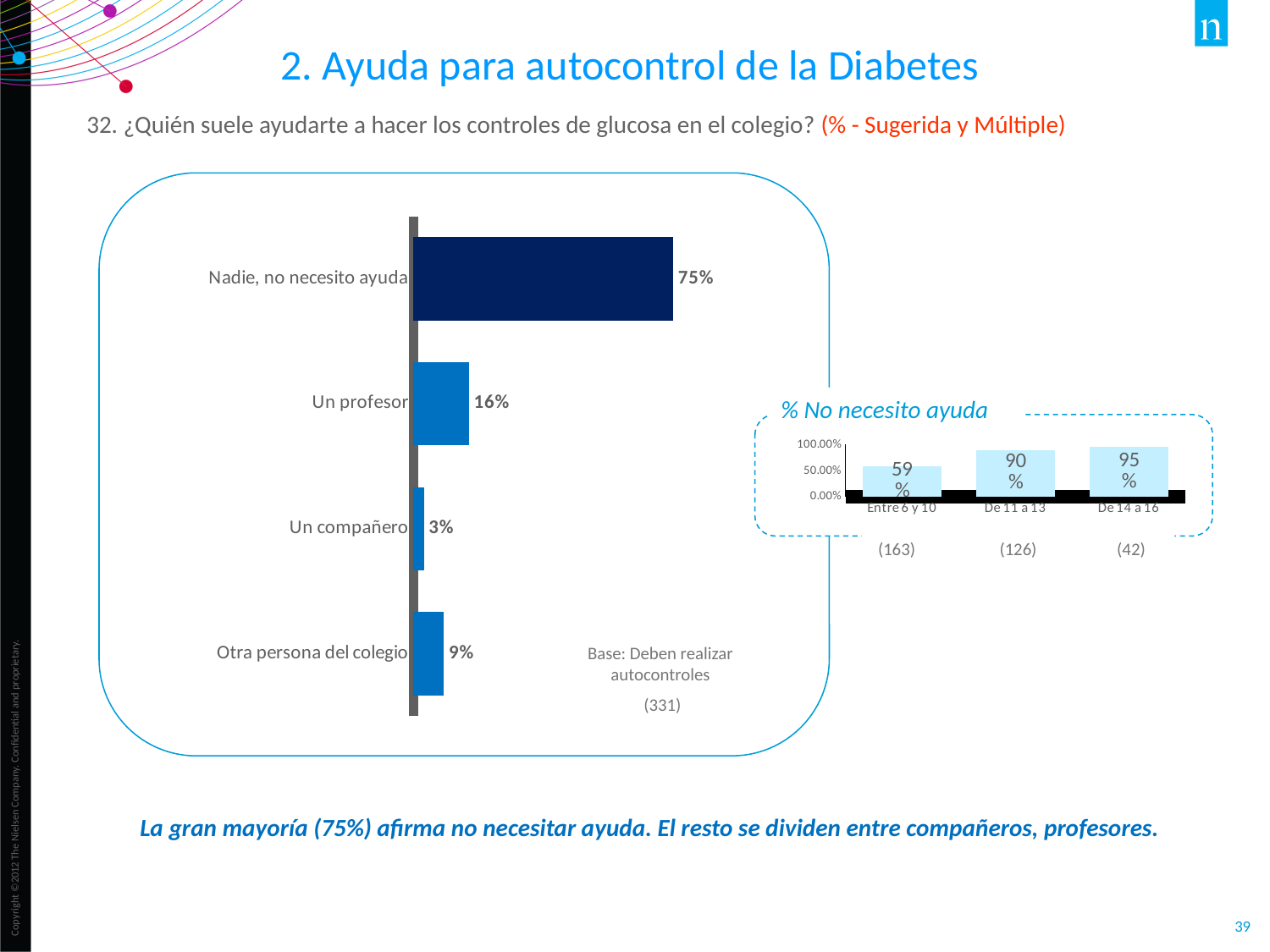
How many categories does the large bar chart on the left show? 4 In the '% No necesito ayuda' chart, which age group has the lowest value? Entre 6 y 10 In the '% No necesito ayuda' chart, do the values rise or fall from left to right along the x axis? Rise In the large bar chart on the left, what is the value for 'Otra persona del colegio'? 9% In the large bar chart on the left, which is larger: 'Otra persona del colegio' or 'Un compañero'? Otra persona del colegio In the '% No necesito ayuda' chart, what is the value for 'De 11 a 13'? 90% In the '% No necesito ayuda' chart, what is the difference between 'De 14 a 16' and 'Entre 6 y 10'? 36% In the large bar chart on the left, which category has the highest value? Nadie, no necesito ayuda What kind of chart is the large chart on the left? Bar chart In the large bar chart on the left, what is the value for 'Un profesor'? 16% In the large bar chart on the left, which category has the lowest value? Un compañero In the large bar chart on the left, what is the difference between 'Nadie, no necesito ayuda' and 'Un profesor'? 59%